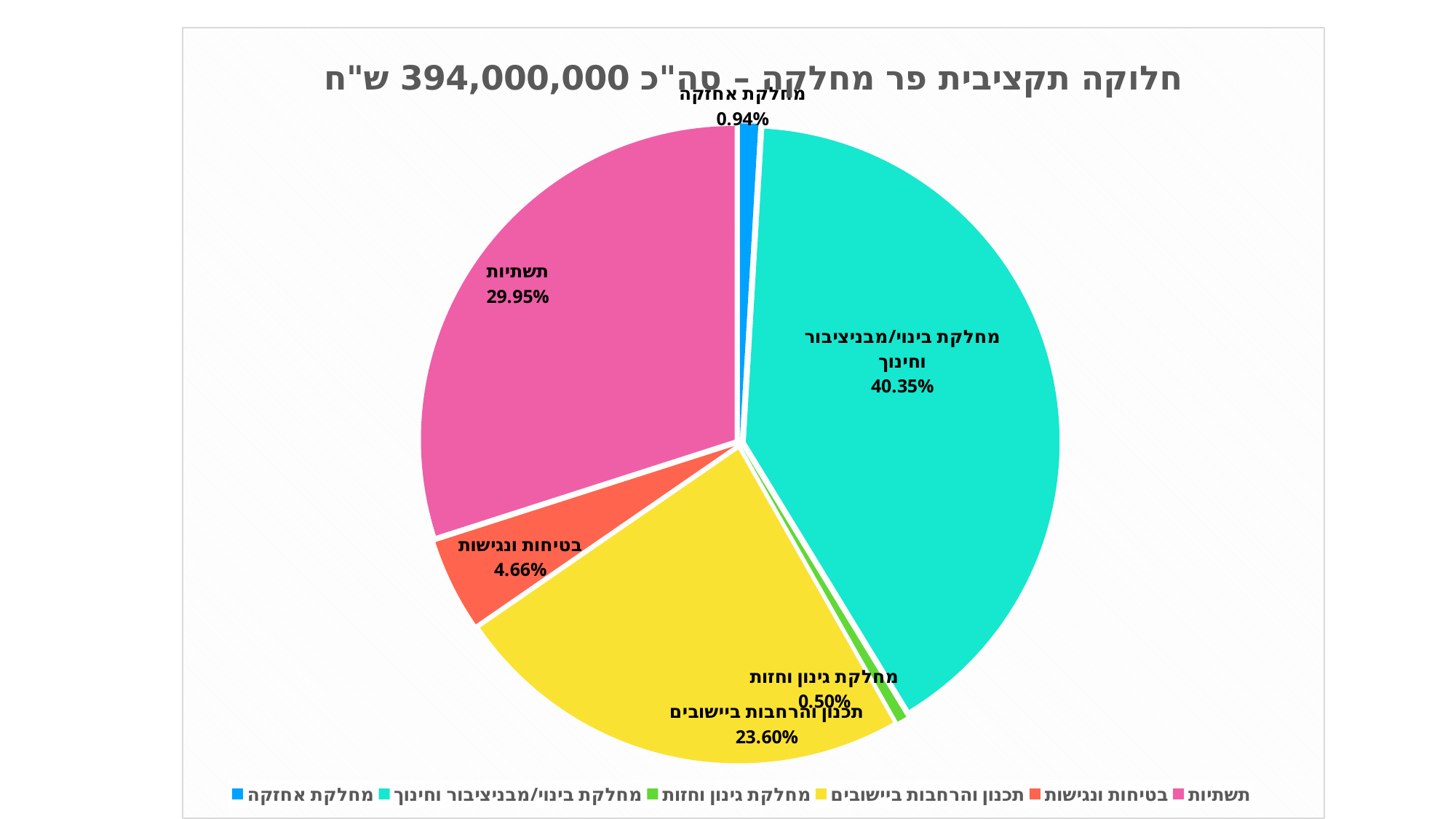
What percentage is shown for מחלקת אחזקה? 0.94% Which is larger, the slice for בטיחות ונגישות or the slice for מחלקת אחזקה? בטיחות ונגישות Which category has the largest slice of the pie? מחלקת בינוי/מבניציבור וחינוך How many slices does the pie chart have? 6 What total amount is stated in the chart title? 394,000,000 ש"ח What is the difference in percentage points between תשתיות and תכנון והרחבות ביישובים? 6.35 What share of the pie does the slice for תשתיות represent? 29.95% What percentage is shown for בטיחות ונגישות? 4.66% Which category has the smallest slice of the pie? מחלקת גינון וחזות What kind of chart is shown on the slide? pie chart What percentage is shown for תכנון והרחבות ביישובים? 23.60% What percentage is shown for מחלקת בינוי/מבניציבור וחינוך? 40.35%